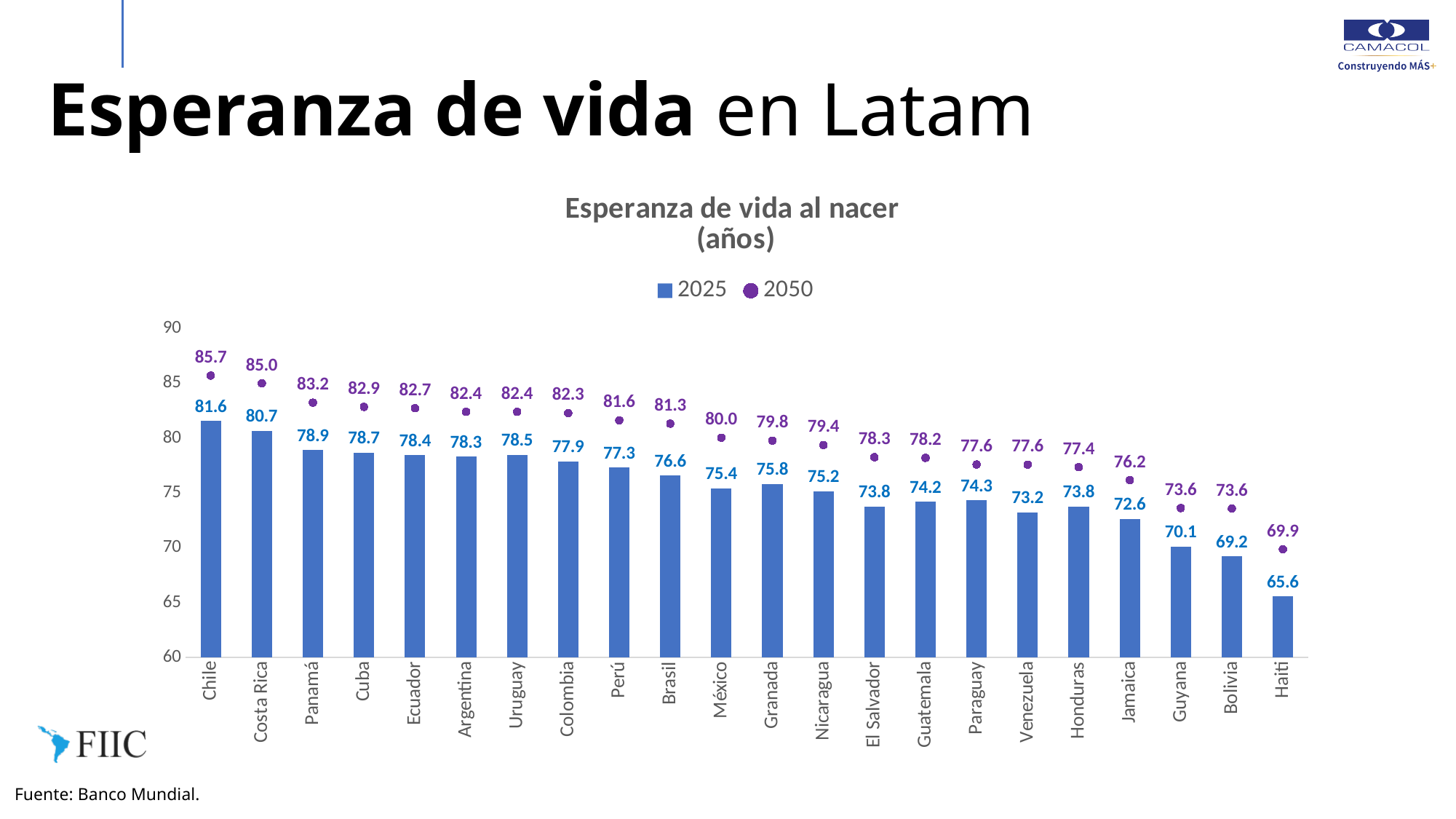
What is the 2025 life expectancy value shown for Colombia? 77.9 Which has the larger 2025 value, Uruguay or Argentina? Uruguay Is the 2025 value for Guyana greater or less than 75? less What kind of chart is used to show the 2025 series? bar chart By how much is Chile's 2050 value higher than its 2025 value? 4.1 How many series does the legend list? 2 What is the 2050 life expectancy value shown for Haití? 69.9 Which country has the lowest 2050 life expectancy? Haití Which country has the highest 2025 life expectancy? Chile Do the 2025 values generally rise or fall from left to right along the x axis? fall How many countries are shown on the x axis? 22 What is the 2050 value shown for Panamá? 83.2